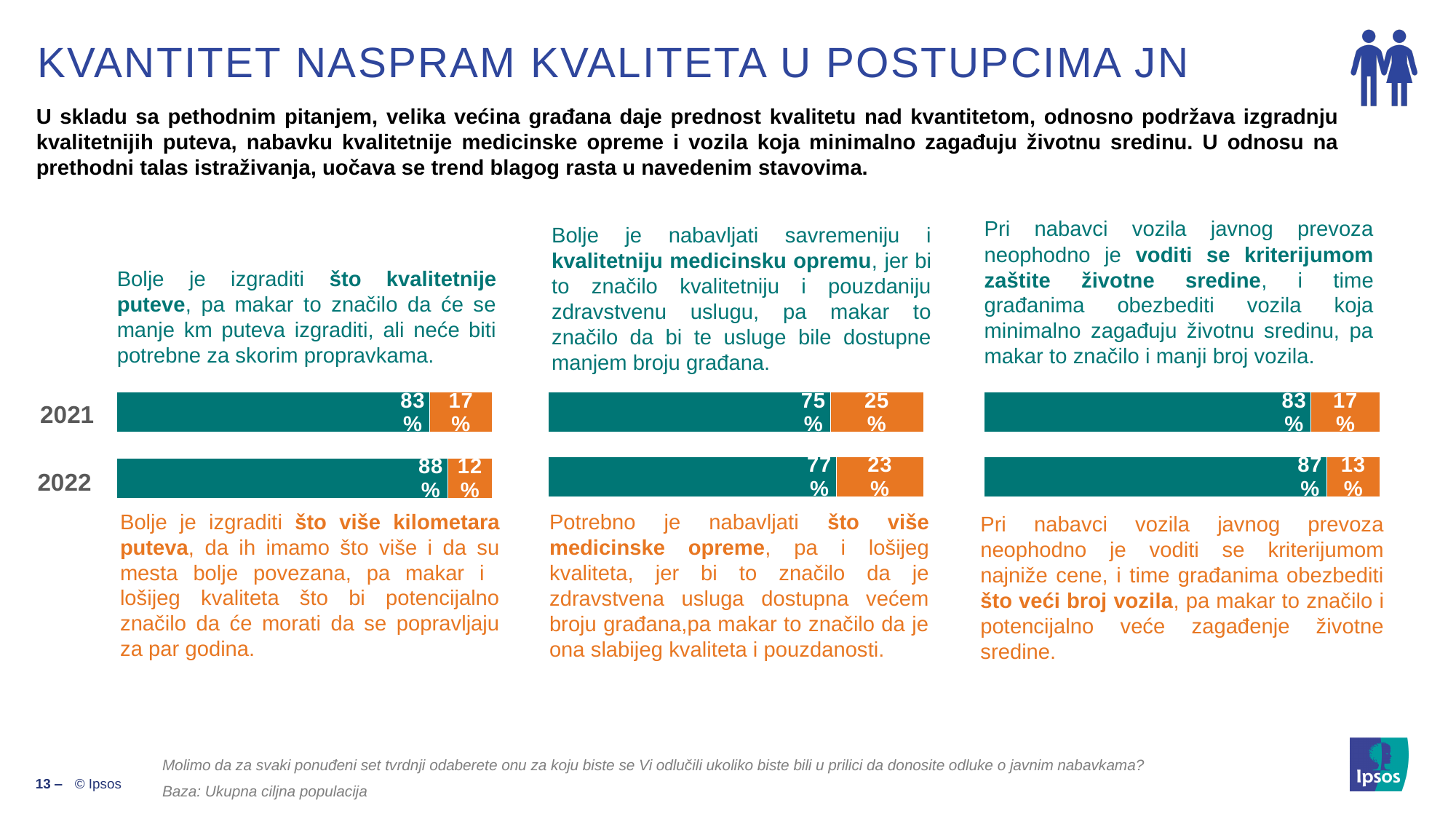
In the right chart, does the orange value rise or fall from 2021 to 2022? fall In the left chart, by how many percentage points did the teal value increase from 2021 to 2022? 5 In the right chart, what is the orange (lowest price / more vehicles) value for 2021? 17% In the middle chart, what is the total of the 2021 stacked bar? 100% In the middle chart, what is the teal (higher-quality medical equipment) value for 2021? 75% In the left chart, what is the orange (more kilometres of roads) value for 2021? 17% In the middle chart, what is the orange (more medical equipment) value for 2022? 23% How many years (rows) are shown in each chart? 2 In the right chart, what is the teal (environmental criterion) value for 2022? 87% In the middle chart, which year has the larger teal value, 2021 or 2022? 2022 What type of chart is used on this slide? Stacked bar chart In the left chart, what is the teal (quality roads) value for 2022? 88%